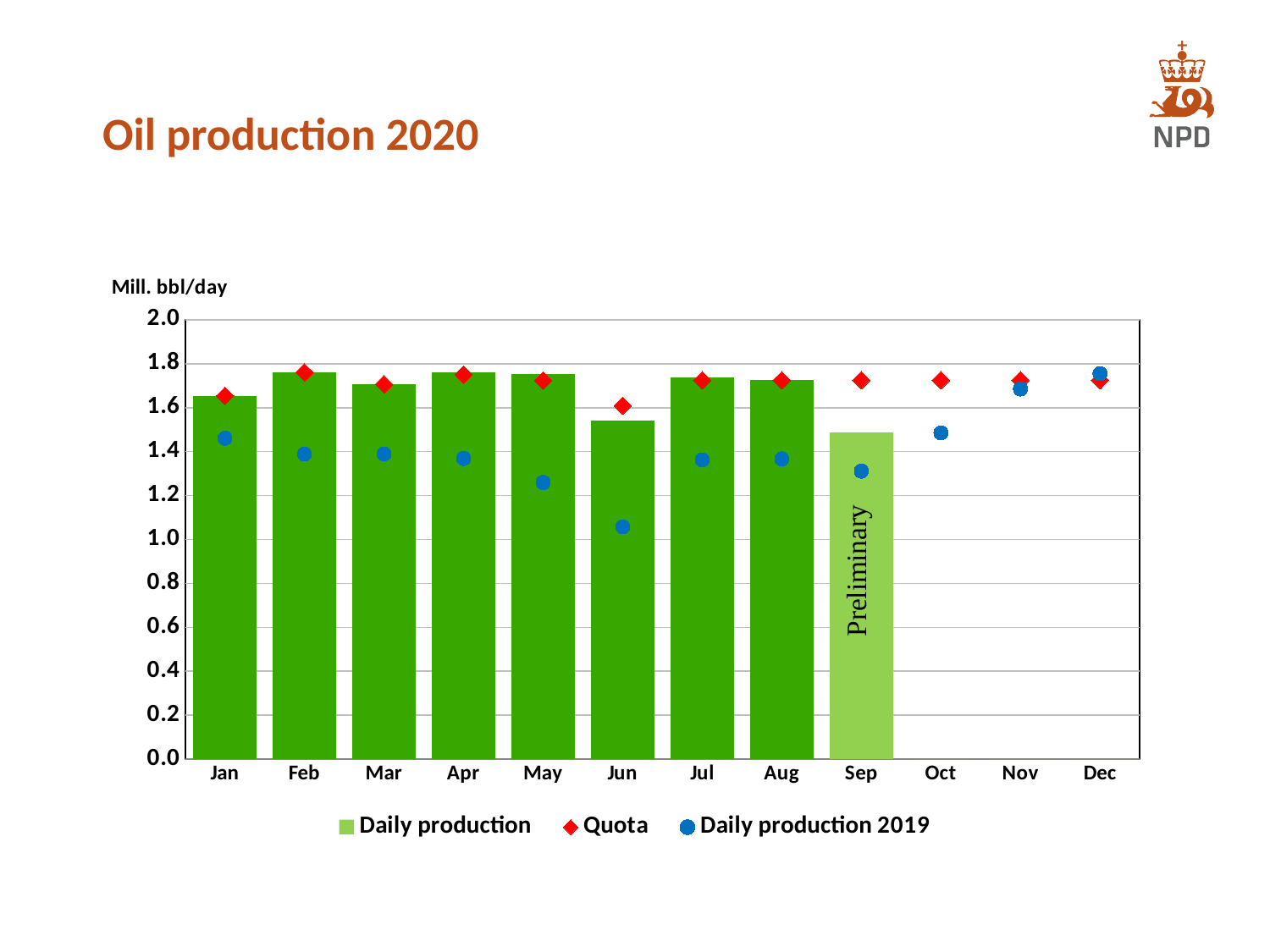
How many months have a Daily production bar plotted? 9 Which month's bar is labelled 'Preliminary'? Sep Is the Daily production value for Jun greater or less than 1.6? less How many months are shown on the x axis? 12 How many series does the legend list? 3 Which month has the lowest Daily production 2019 value? Jun Is the Daily production value for Sep greater or less than 1.4? greater Do the Daily production 2019 values rise or fall from Sep to Dec? rise Which is larger, the Daily production bar for Jun or for Jul? Jul What kind of chart is shown on the slide? Bar chart with point markers Which month has the lowest Daily production bar? Sep Is the Daily production 2019 value for Jun greater or less than 1.2? less